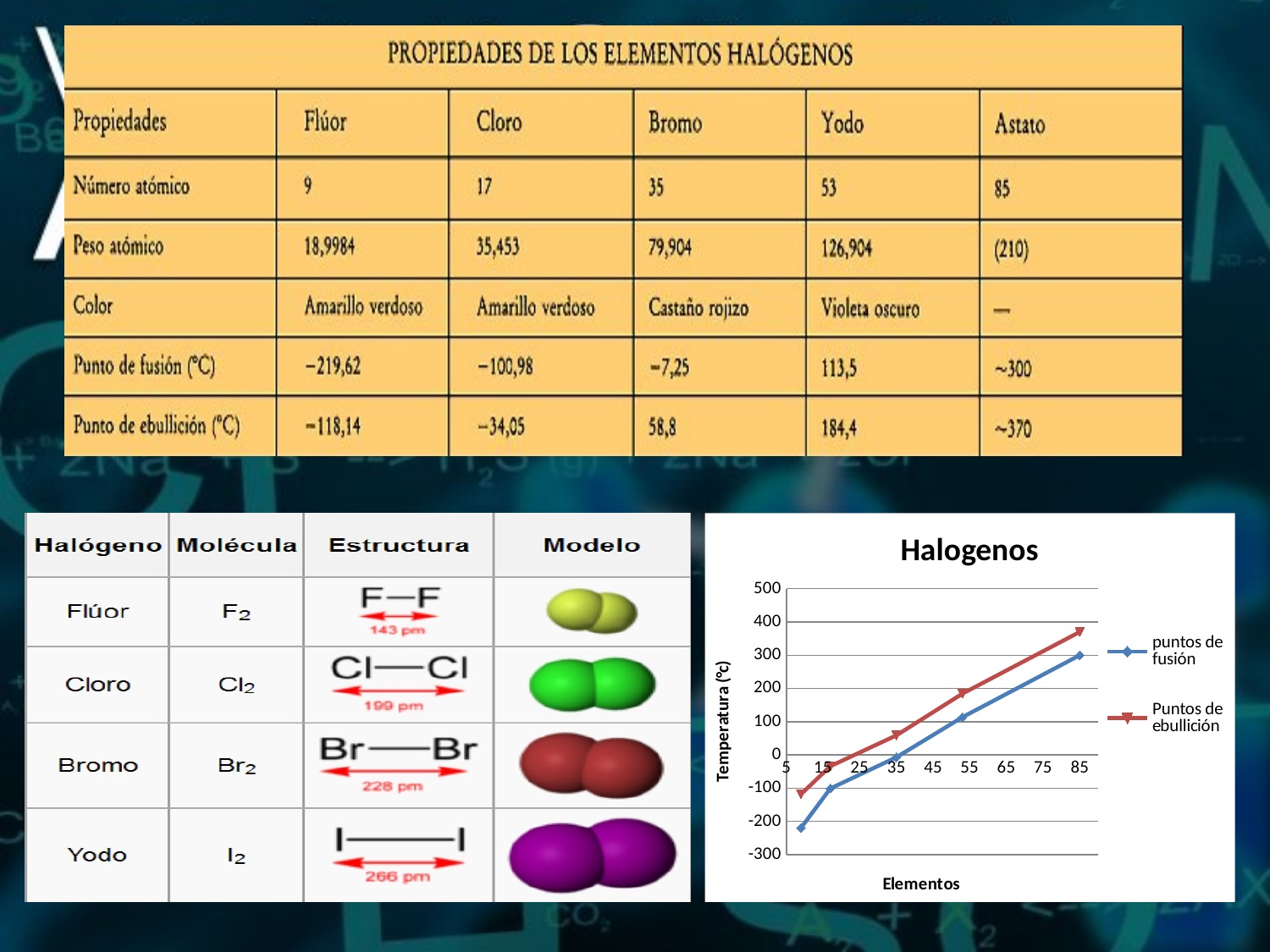
What is the y-axis label of the 'Halogenos' chart? Temperatura (°c) In the 'Halogenos' chart, is the last 'Puntos de ebullición' point (at x = 85) greater or less than 300? greater What kind of chart is the 'Halogenos' chart? line chart What are the two series named in the legend of the 'Halogenos' chart? puntos de fusión and Puntos de ebullición In the 'Halogenos' chart, is the 'Puntos de ebullición' point near x = 55 greater or less than 100? greater How many series does the legend of the 'Halogenos' chart list? 2 In the 'Halogenos' chart, at x = 85, which series has the larger value: 'puntos de fusión' or 'Puntos de ebullición'? Puntos de ebullición How many data points does the 'puntos de fusión' series have in the 'Halogenos' chart? 5 In the 'Halogenos' chart, is the first 'puntos de fusión' point (near x = 5) greater or less than -200? less In the 'Halogenos' chart, do the values of the 'puntos de fusión' series rise or fall as the x axis increases? rise In the 'Halogenos' chart, do the values of the 'Puntos de ebullición' series rise or fall as the x axis increases? rise